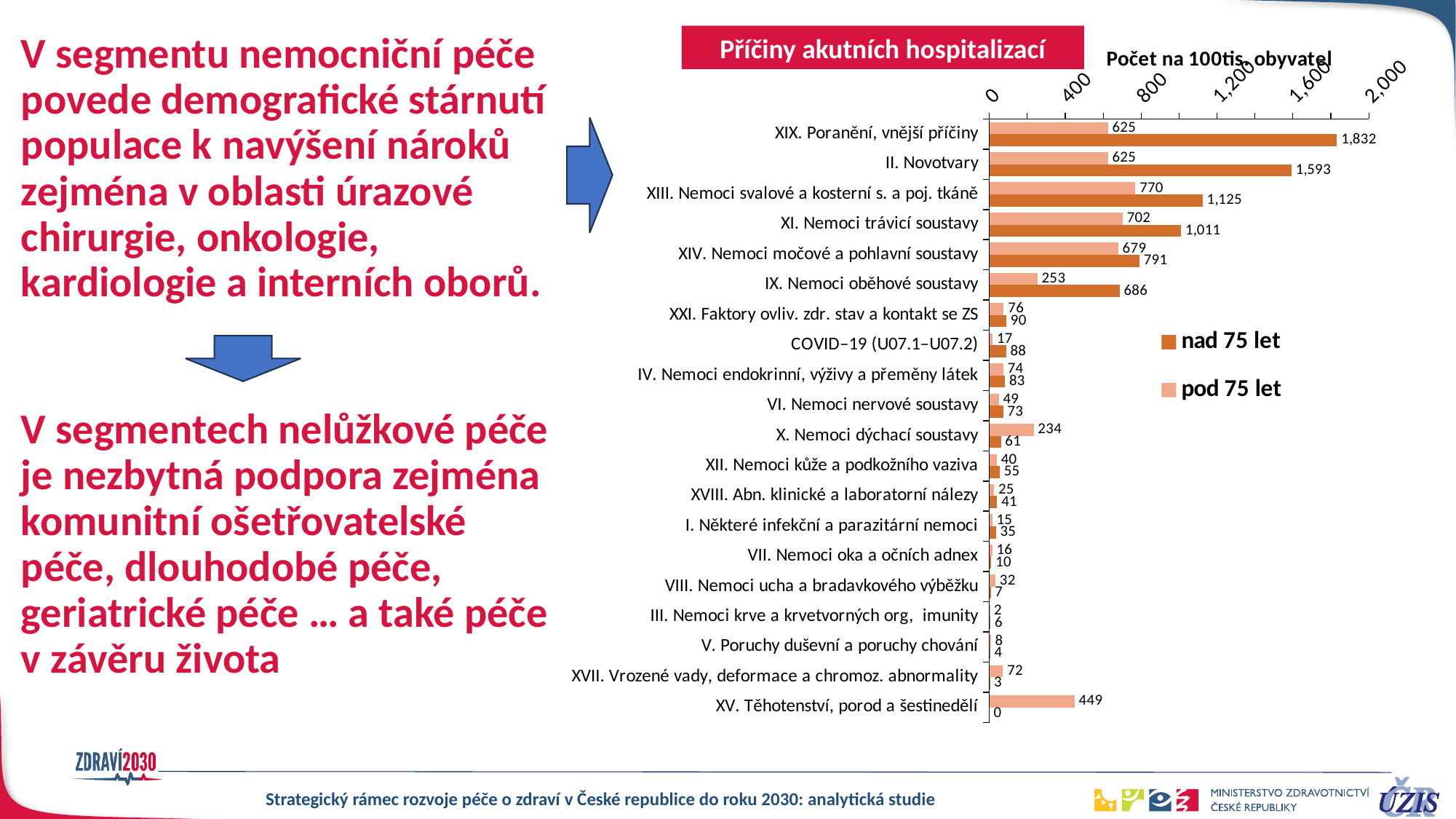
What is the difference between the 'nad 75 let' and 'pod 75 let' values for 'II. Novotvary'? 968 Which category has the lowest value for 'nad 75 let'? XV. Těhotenství, porod a šestinedělí Which category has the highest value for 'nad 75 let'? XIX. Poranění, vnější příčiny How many categories are shown on the chart? 20 What is the value for 'nad 75 let' in the category 'XIX. Poranění, vnější příčiny'? 1,832 What is the value for 'pod 75 let' in the category 'XV. Těhotenství, porod a šestinedělí'? 449 What is the value for 'nad 75 let' in the category 'COVID–19 (U07.1–U07.2)'? 88 What is the title of the chart? Příčiny akutních hospitalizací What type of chart is shown on the slide? bar chart For 'X. Nemoci dýchací soustavy', which is larger: the 'nad 75 let' value or the 'pod 75 let' value? pod 75 let How many series does the legend list? 2 Which category has the highest value for 'pod 75 let'? XIII. Nemoci svalové a kosterní s. a poj. tkáně